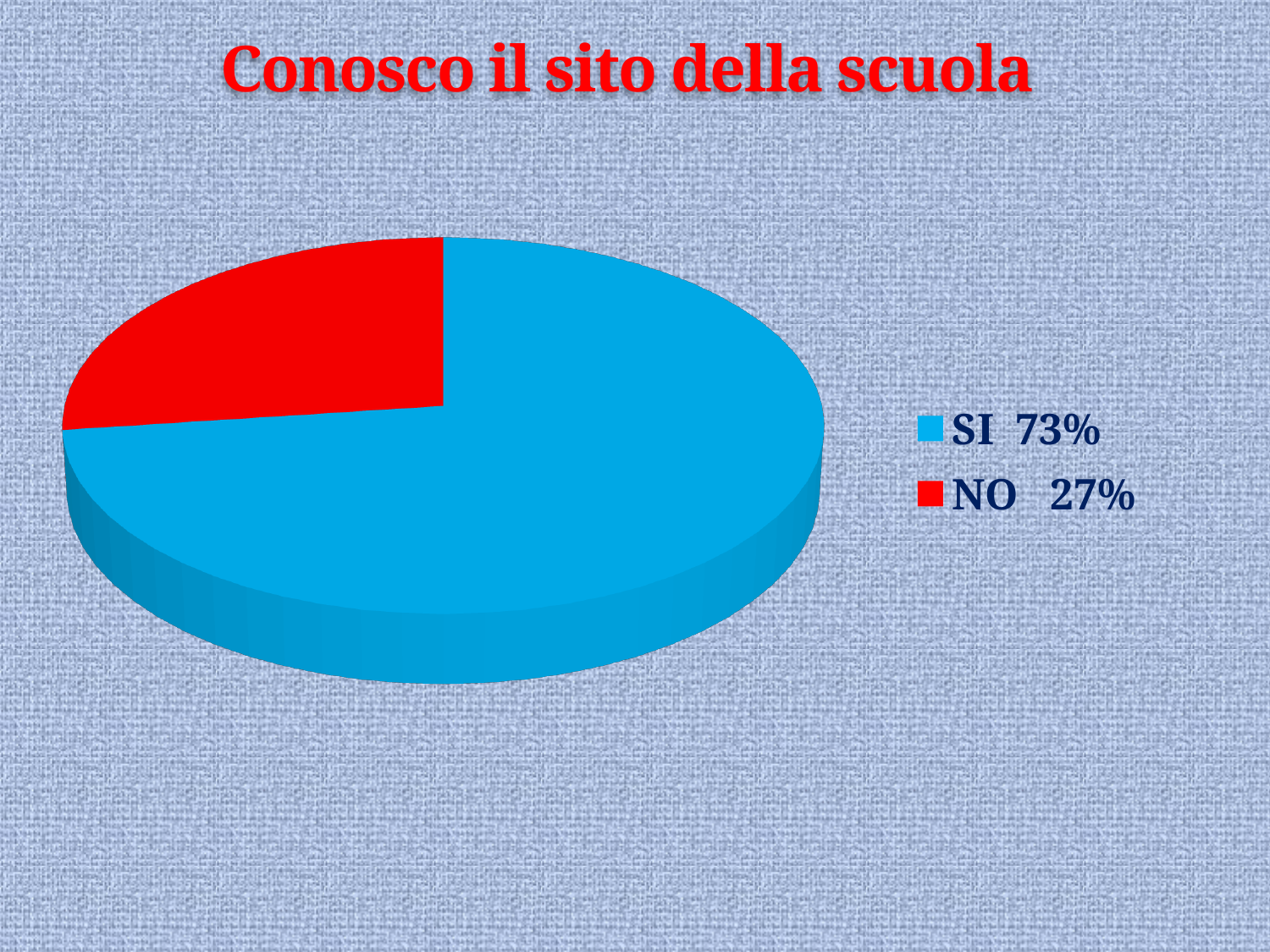
What colour is the slice for NO? red What share of the pie does SI represent? 73% What kind of chart is shown on the slide? pie chart What is the total of the two slices shown in the legend? 100% What is the title of the chart? Conosco il sito della scuola How many entries does the legend list? 2 Which category has the smallest slice of the pie? NO What is the difference in percentage points between SI and NO? 46 Which category has the largest slice of the pie? SI Which is larger, the share for SI or the share for NO? SI What share of the pie does NO represent? 27% How many categories does the pie chart have? 2